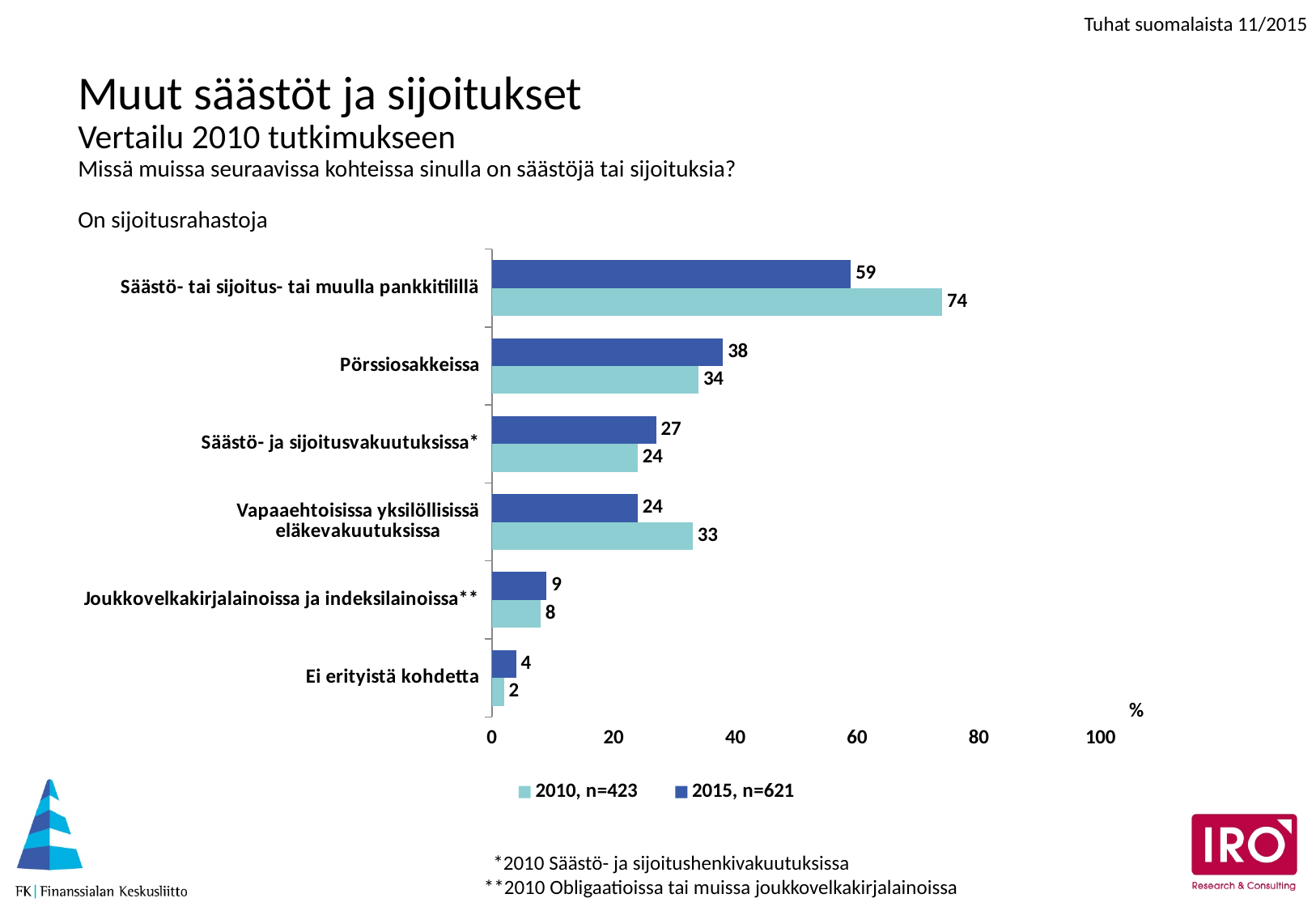
Which category has the highest 2015 value? Säästö- tai sijoitus- tai muulla pankkitilillä What is the 2010 value for Säästö- tai sijoitus- tai muulla pankkitilillä? 74 How many series does the legend list? 2 What is the 2010 value for Vapaaehtoisissa yksilöllisissä eläkevakuutuksissa? 33 Which is larger for Vapaaehtoisissa yksilöllisissä eläkevakuutuksissa, the 2010 value or the 2015 value? 2010 What is the 2015 value for Pörssiosakkeissa? 38 Is the 2015 value for Säästö- ja sijoitusvakuutuksissa* greater or less than 20? greater How many categories are shown on the chart? 6 Which category has the lowest 2010 value? Ei erityistä kohdetta What kind of chart is shown on the slide? Bar chart What is the difference between the 2010 and 2015 values for Säästö- tai sijoitus- tai muulla pankkitilillä? 15 What are the two legend entries of the chart? 2010, n=423 and 2015, n=621